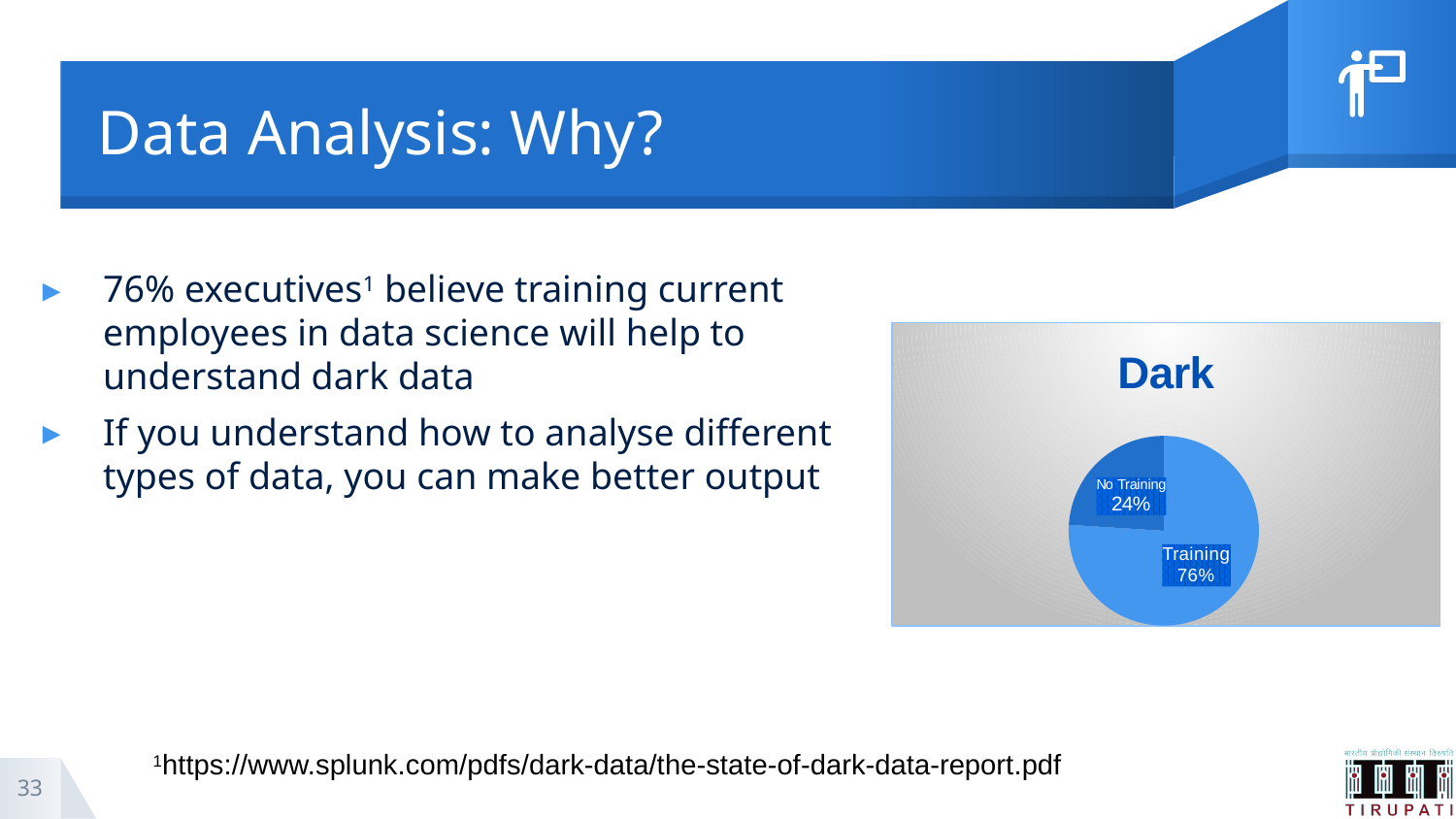
Which is larger, the Training slice or the No Training slice? Training What share of the pie does the No Training slice take? 24% Which slice is the smallest in the pie chart? No Training What is the title of the chart? Dark What type of chart is shown on the slide? pie chart What percentage does the No Training slice represent? 24% Which slice is the largest in the pie chart? Training What is the difference in percentage points between the Training and No Training slices? 52 What percentage does the Training slice represent? 76% How many slices does the pie chart have? 2